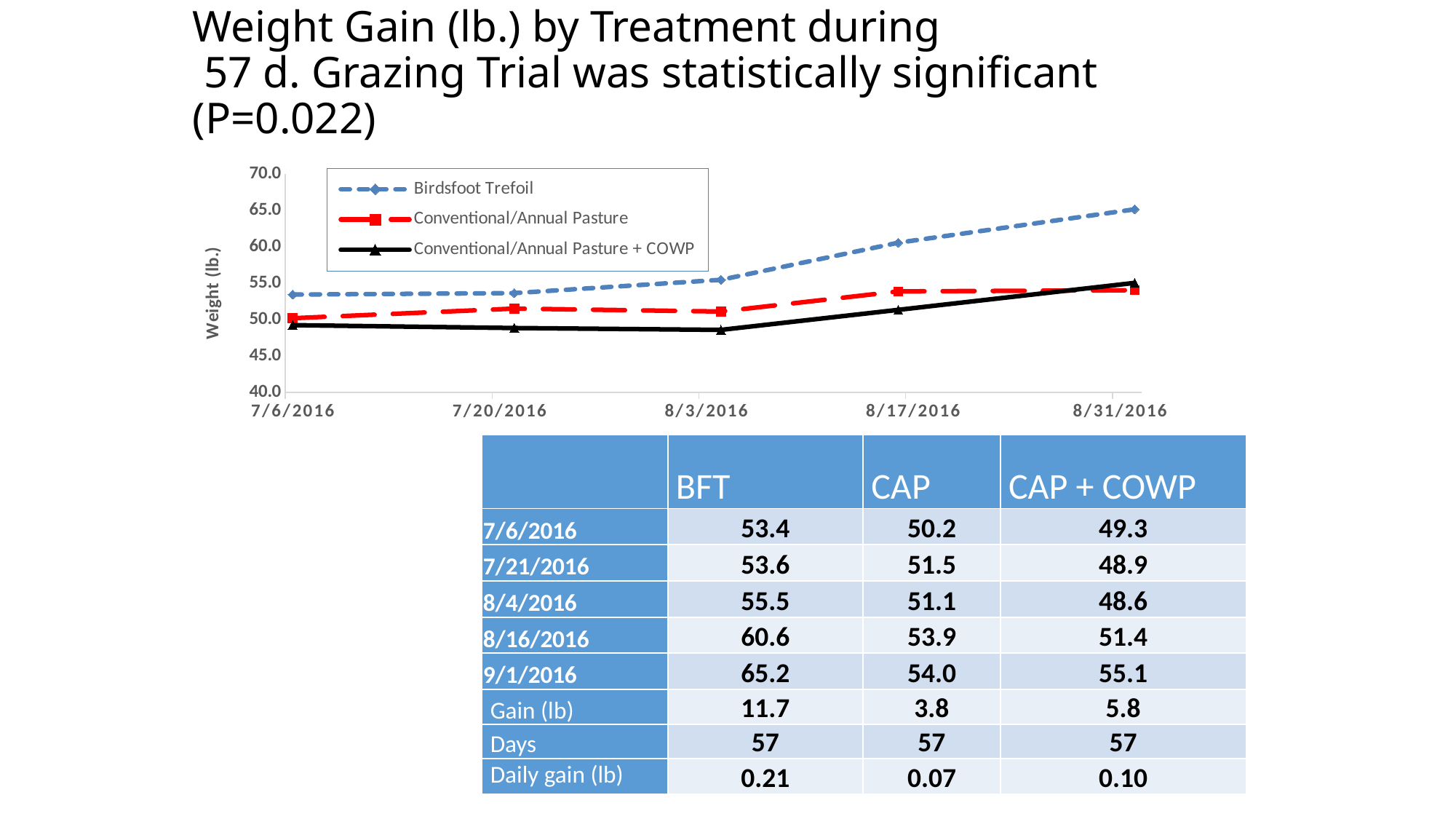
Is the value for Birdsfoot Trefoil on 8/31/2016 greater or less than 60.0? greater Which series has the lowest value on 8/3/2016? Conventional/Annual Pasture + COWP How many series does the chart's legend list? 3 What is the title of the chart's vertical axis? Weight (lb.) Is the value for Conventional/Annual Pasture + COWP on 8/3/2016 greater or less than 50.0? less Does the Birdsfoot Trefoil line rise or fall from 7/6/2016 to 8/31/2016? rise Which series has the highest value on 8/31/2016? Birdsfoot Trefoil How many dates are shown along the x axis of the chart? 5 On 8/17/2016, which is larger: Birdsfoot Trefoil or Conventional/Annual Pasture? Birdsfoot Trefoil Is the value for Conventional/Annual Pasture on 8/17/2016 greater or less than 55.0? less What colour is the Birdsfoot Trefoil line in the chart? blue What kind of chart is shown on the slide? line chart